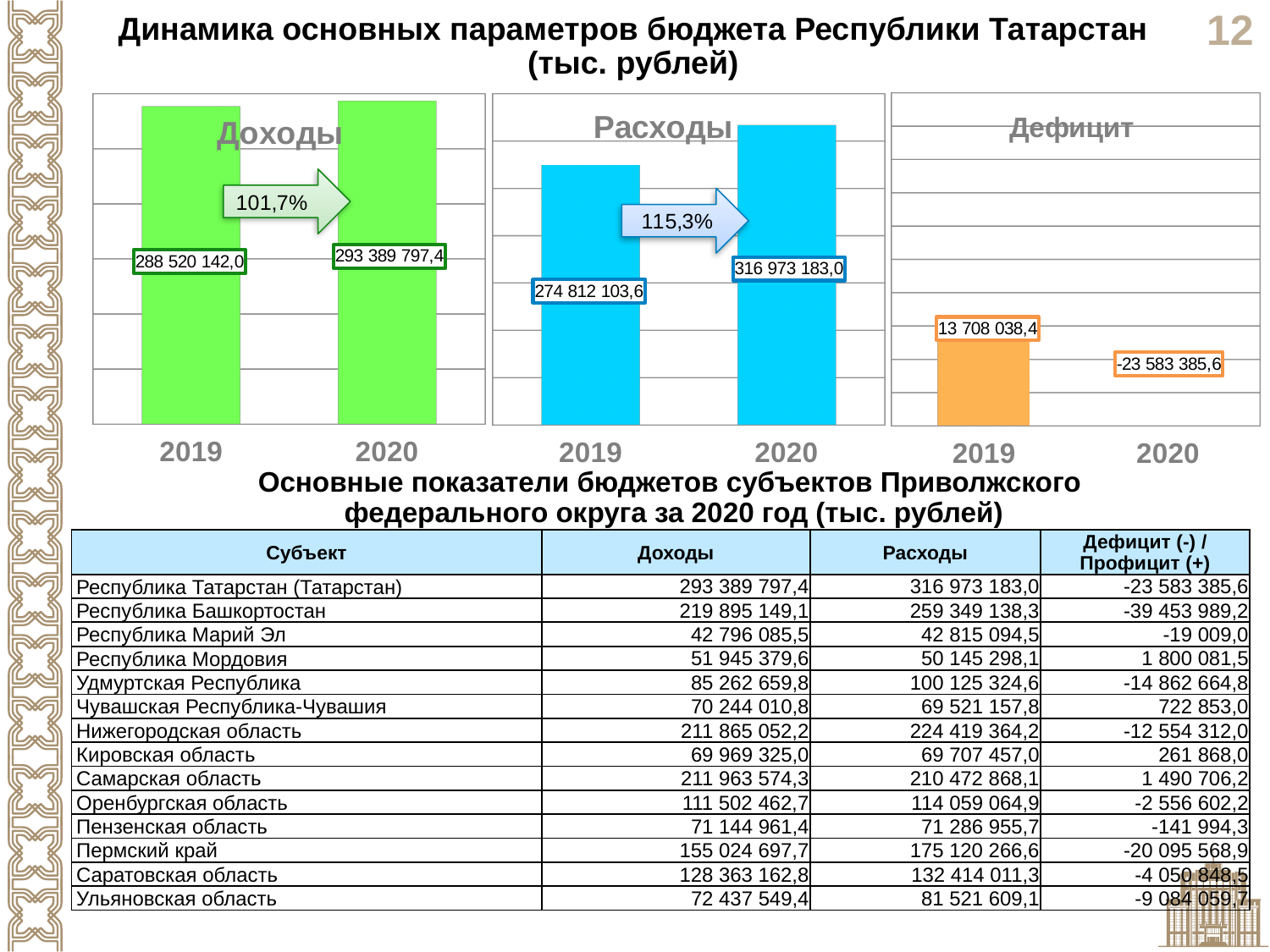
In the Дефицит chart, what is the value for 2019? 13 708 038,4 In the Доходы chart, what is the value for 2020? 293 389 797,4 In the Дефицит chart, do the values rise or fall from 2019 to 2020? fall In the Доходы chart, by how much does the 2020 value exceed the 2019 value? 4 869 655,4 What kind of chart is the Доходы chart? bar chart In the Расходы chart, which year has the higher value, 2019 or 2020? 2020 In the Расходы chart, what is the difference between the 2020 and 2019 values? 42 161 079,4 What percentage is shown on the arrow in the Расходы chart? 115,3% In the Расходы chart, what is the value for 2019? 274 812 103,6 In the Расходы chart, what is the value for 2020? 316 973 183,0 In the Доходы chart, what is the value for 2019? 288 520 142,0 In the Дефицит chart, what is the value for 2020? -23 583 385,6